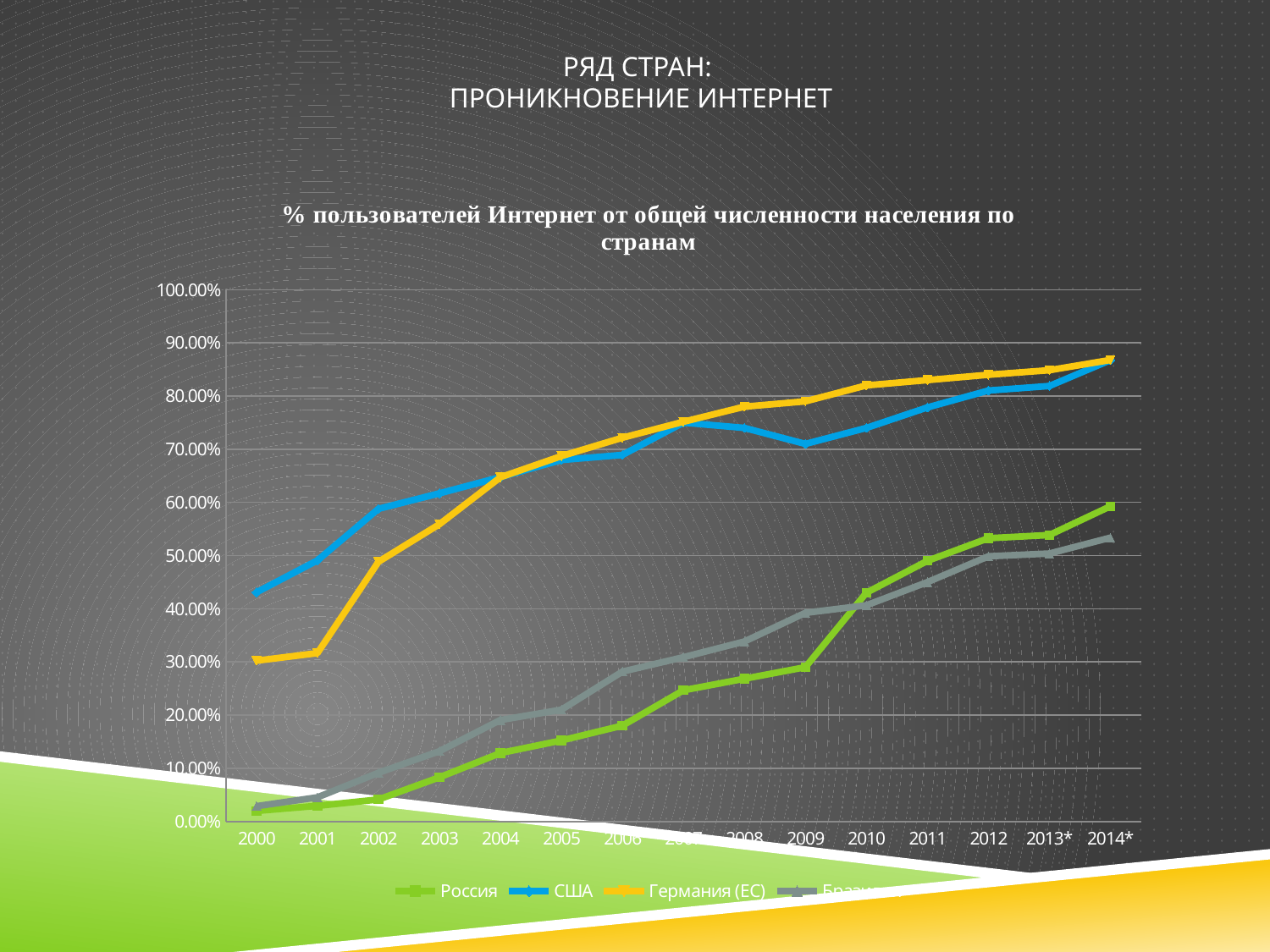
Is the value for США in 2000 greater or less than 40%? greater Is the value for Германия (ЕС) in 2014* greater or less than 80%? greater How many series does the legend list? 4 Is the value for Россия in 2014* greater or less than 50%? greater How many years are shown along the x axis? 15 In 2014*, which is larger: the value for Россия or the value for США? США Which series has the highest value in 2002? США What is the title of the chart? % пользователей Интернет от общей численности населения по странам In 2000, which is larger: the value for США or the value for Германия (ЕС)? США What kind of chart is shown on the slide? line chart